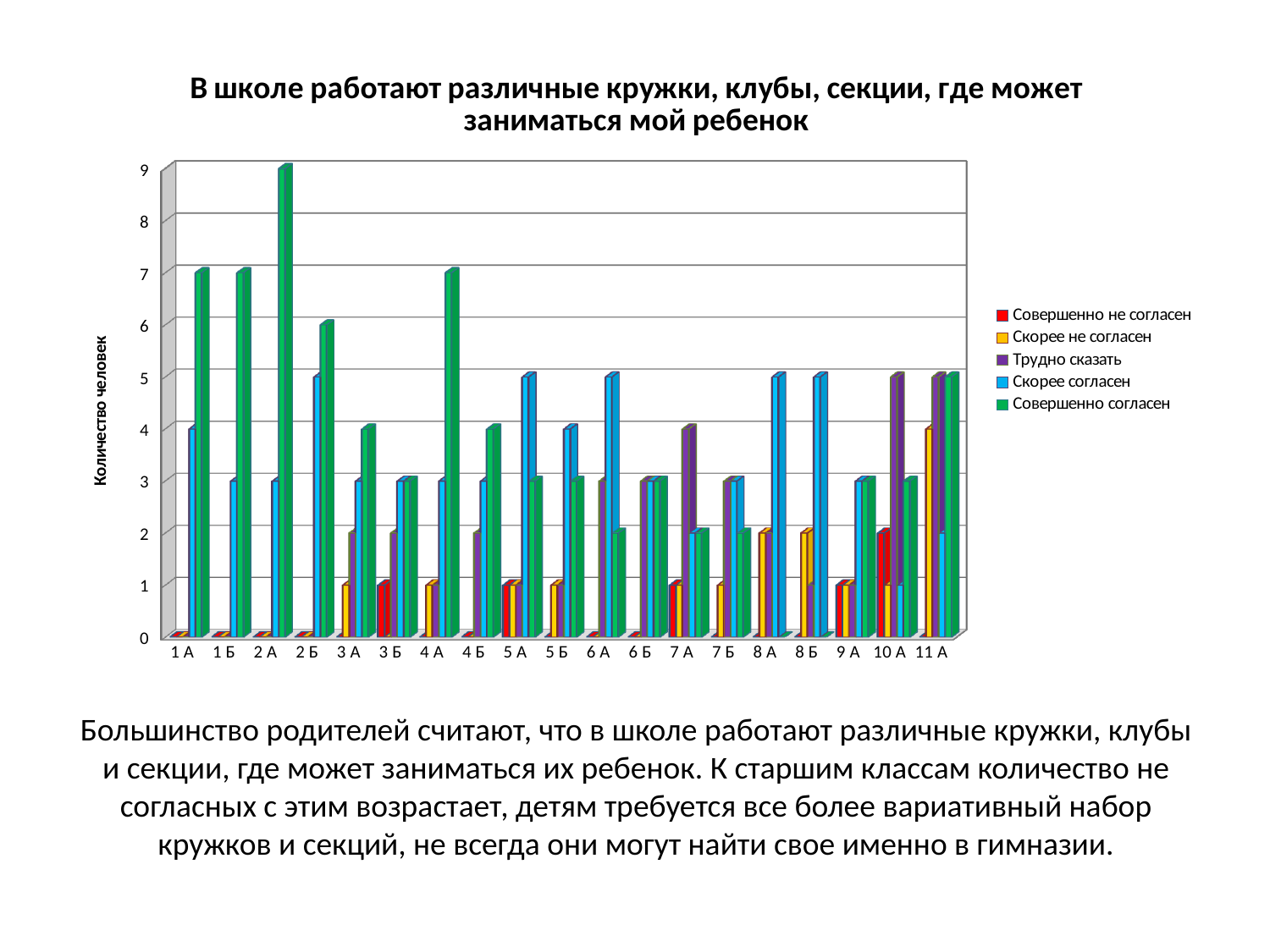
Is the value for 'Совершенно согласен' in class 6 А greater or less than 3? less What kind of chart is shown on the slide? bar chart In class 8 Б, which is larger: 'Скорее согласен' or 'Совершенно согласен'? Скорее согласен Which class has the highest value for 'Совершенно согласен'? 2 А What is the value for 'Совершенно согласен' in class 2 А? 9 Is the value for 'Скорее согласен' in class 8 А greater or less than 4? greater Is the value for 'Совершенно согласен' in class 1 А greater or less than 6? greater What is the label of the vertical axis? Количество человек How many series does the legend list? 5 How many class categories are shown along the x axis? 19 Which is larger: 'Совершенно согласен' for class 2 А or for class 2 Б? 2 А